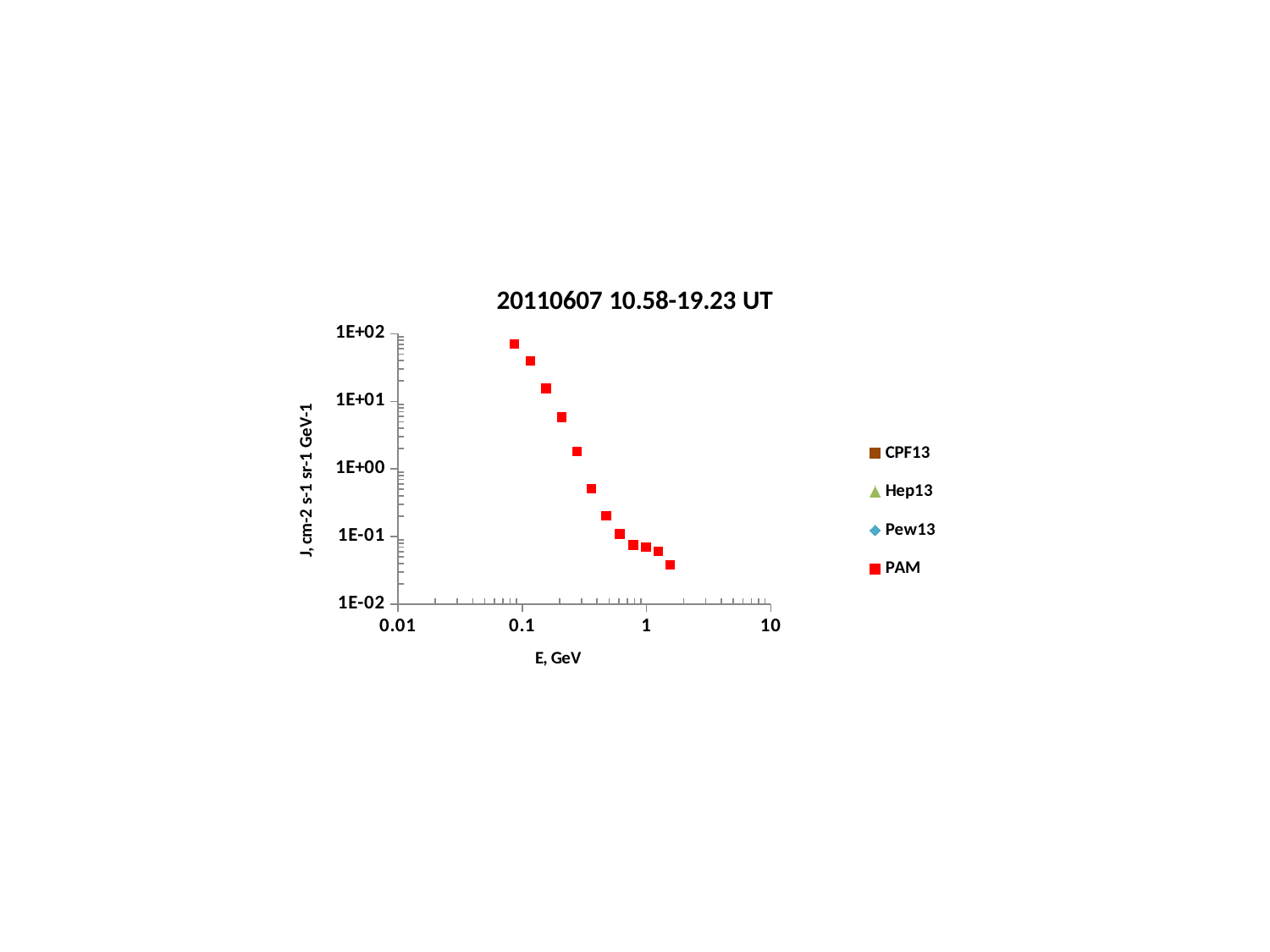
Is the value of the PAM point at the lowest energy greater or less than 1E+01? greater Do the plotted PAM values rise or fall as E increases along the x axis? fall What is the lowest tick value shown on the x axis? 0.01 Is the value of the PAM point at the highest energy greater or less than 1E-02? greater What kind of chart is shown on the slide? scatter chart What is the highest tick value shown on the y axis? 1E+02 Is the value of the PAM point at the highest energy greater or less than 1E-01? less Which PAM point has the highest J value: the one at the lowest energy or the one at the highest energy? the one at the lowest energy How many series does the legend list? 4 What is the label of the x axis? E, GeV